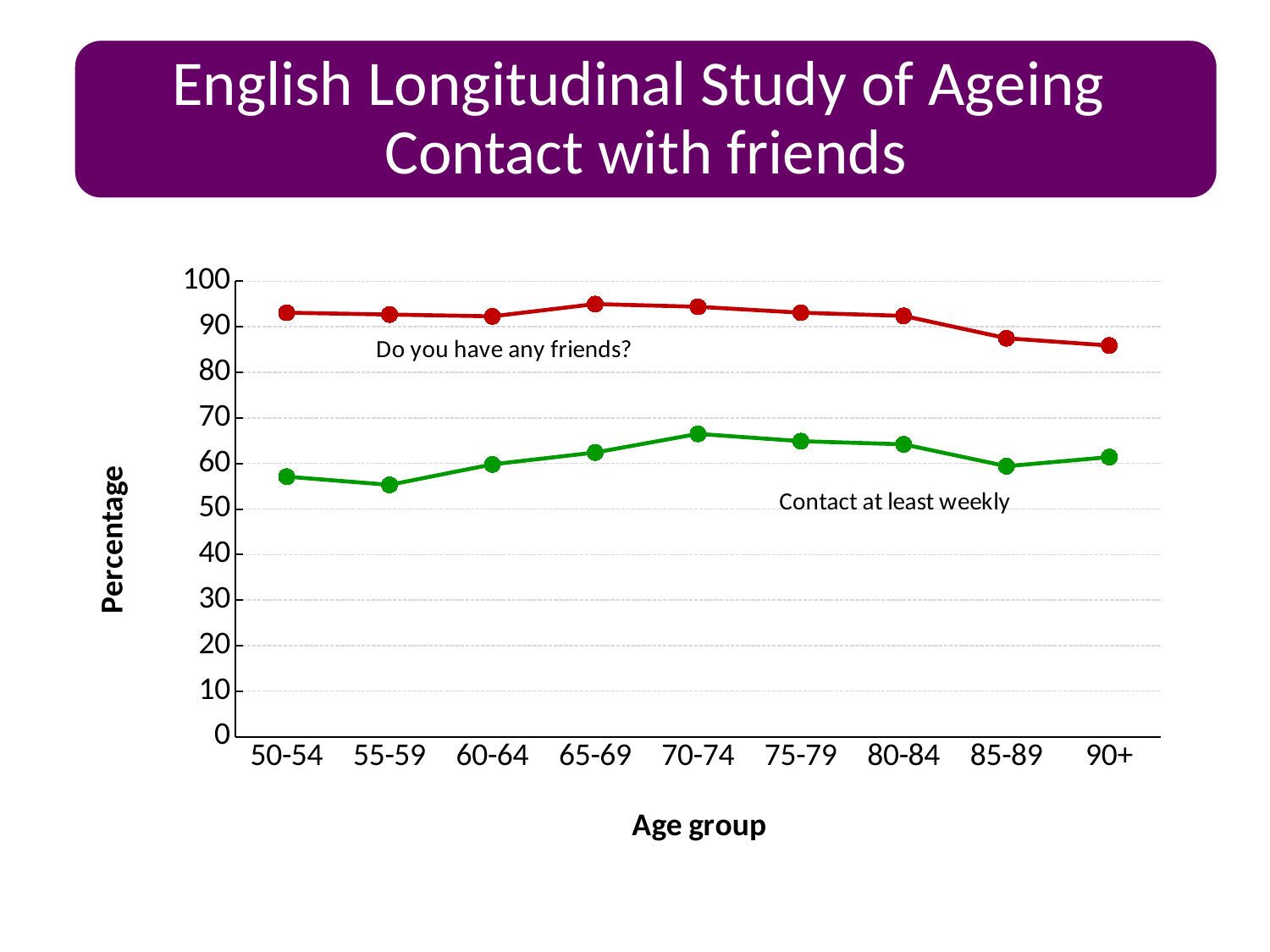
Is the value for the 70-74 age group on the 'Contact at least weekly' line greater or less than 60? greater Does the 'Do you have any friends?' line rise or fall from the 80-84 age group to the 90+ age group? Fall On the 'Contact at least weekly' line, which is larger: the value for 70-74 or the value for 50-54? 70-74 What is the label of the x axis? Age group What kind of chart is shown on the slide? Line chart How many age groups are plotted along the x axis? 9 How many data series are plotted on the chart? 2 Is the value for the 65-69 age group on the 'Do you have any friends?' line greater or less than 90? greater Which age group has the lowest value on the 'Contact at least weekly' line? 55-59 Which age group has the highest value on the 'Contact at least weekly' line? 70-74 Is the value for the 50-54 age group on the 'Contact at least weekly' line greater or less than 60? less